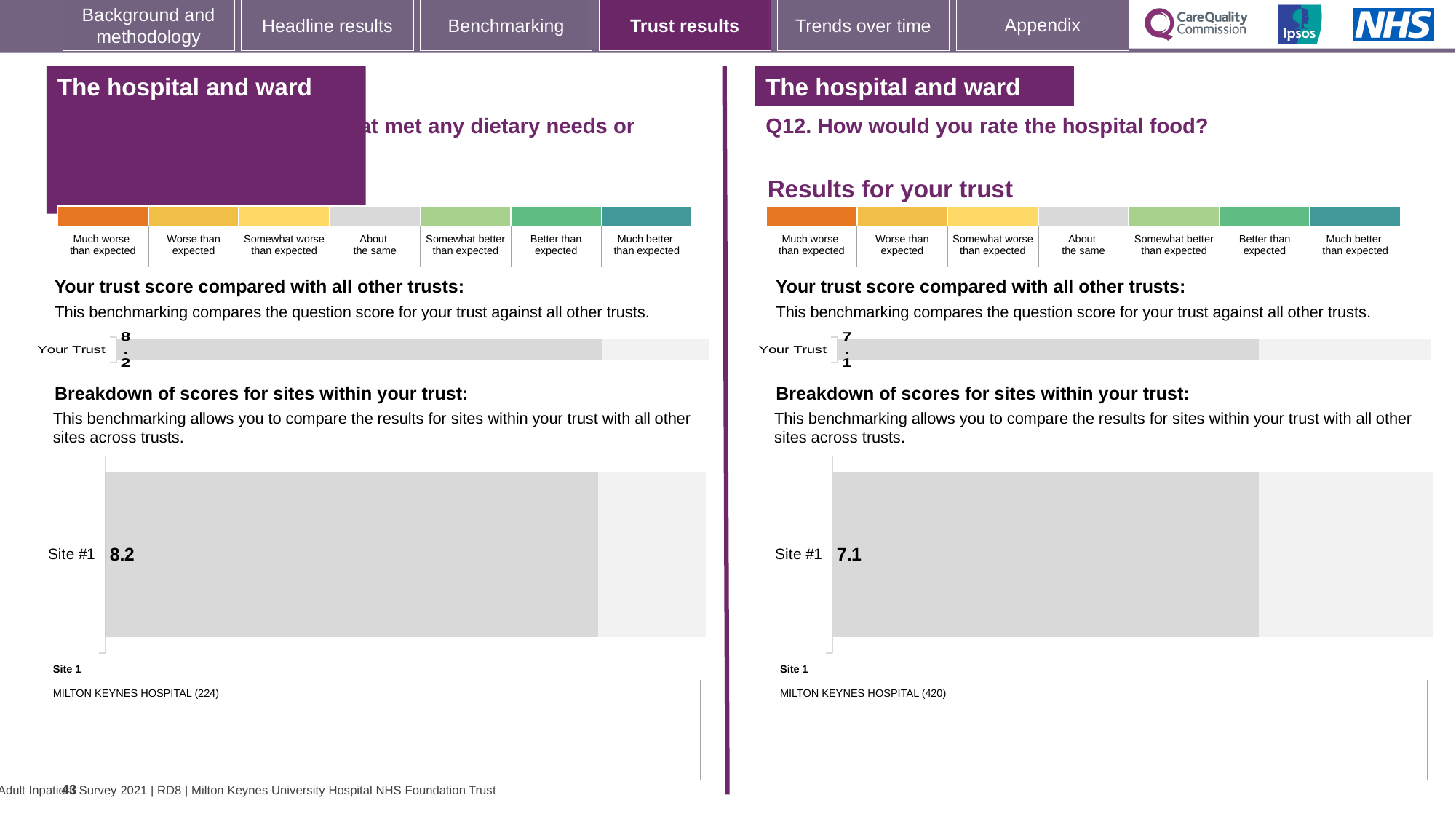
On the right-hand panel (Q12. How would you rate the hospital food?), what is the score shown for Your Trust? 7.1 On the right-hand panel (Q12. How would you rate the hospital food?), what is the score shown for Site #1? 7.1 On the right-hand panel (Q12), is the Your Trust score the same as the Site #1 score? Yes Which is larger: the Site #1 score on the left-hand panel or the Site #1 score on the right-hand panel (Q12)? Left-hand panel (8.2) On the left-hand panel, what is the score shown for Your Trust? 8.2 On the right-hand panel (Q12), which site name is listed as Site 1? MILTON KEYNES HOSPITAL (420) How many sites are shown in the 'Breakdown of scores for sites within your trust' chart on the right-hand panel (Q12)? 1 What is the difference between the Your Trust score on the left-hand panel and the Your Trust score on the right-hand panel (Q12)? 1.1 On the left-hand panel, what is the score shown for Site #1? 8.2 What type of chart is used to show the Site #1 score on the right-hand panel (Q12)? Bar chart On the left-hand panel, which site name is listed as Site 1? MILTON KEYNES HOSPITAL (224)